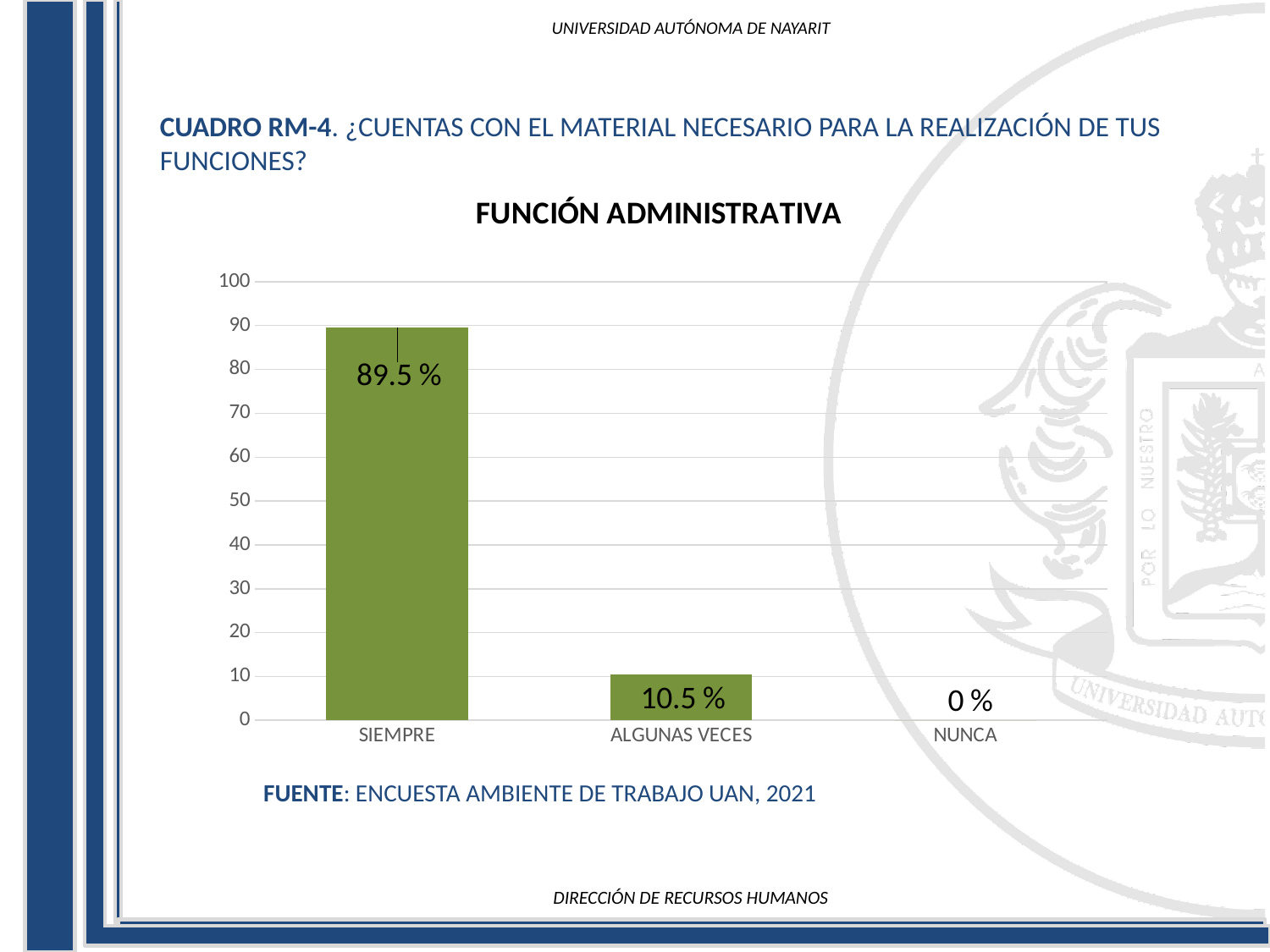
How many categories are shown on the x axis? 3 What is the title of the chart? FUNCIÓN ADMINISTRATIVA What is the value for NUNCA? 0 % What is the value for SIEMPRE? 89.5 % What is the value for ALGUNAS VECES? 10.5 % What kind of chart is shown? bar chart Do the values rise or fall from left to right along the x axis? fall Which category has the lowest value? NUNCA Is the value for SIEMPRE greater or less than 80? greater Which category has the highest value? SIEMPRE Which is larger, the value for ALGUNAS VECES or the value for NUNCA? ALGUNAS VECES What is the difference between the values for SIEMPRE and ALGUNAS VECES? 79 %